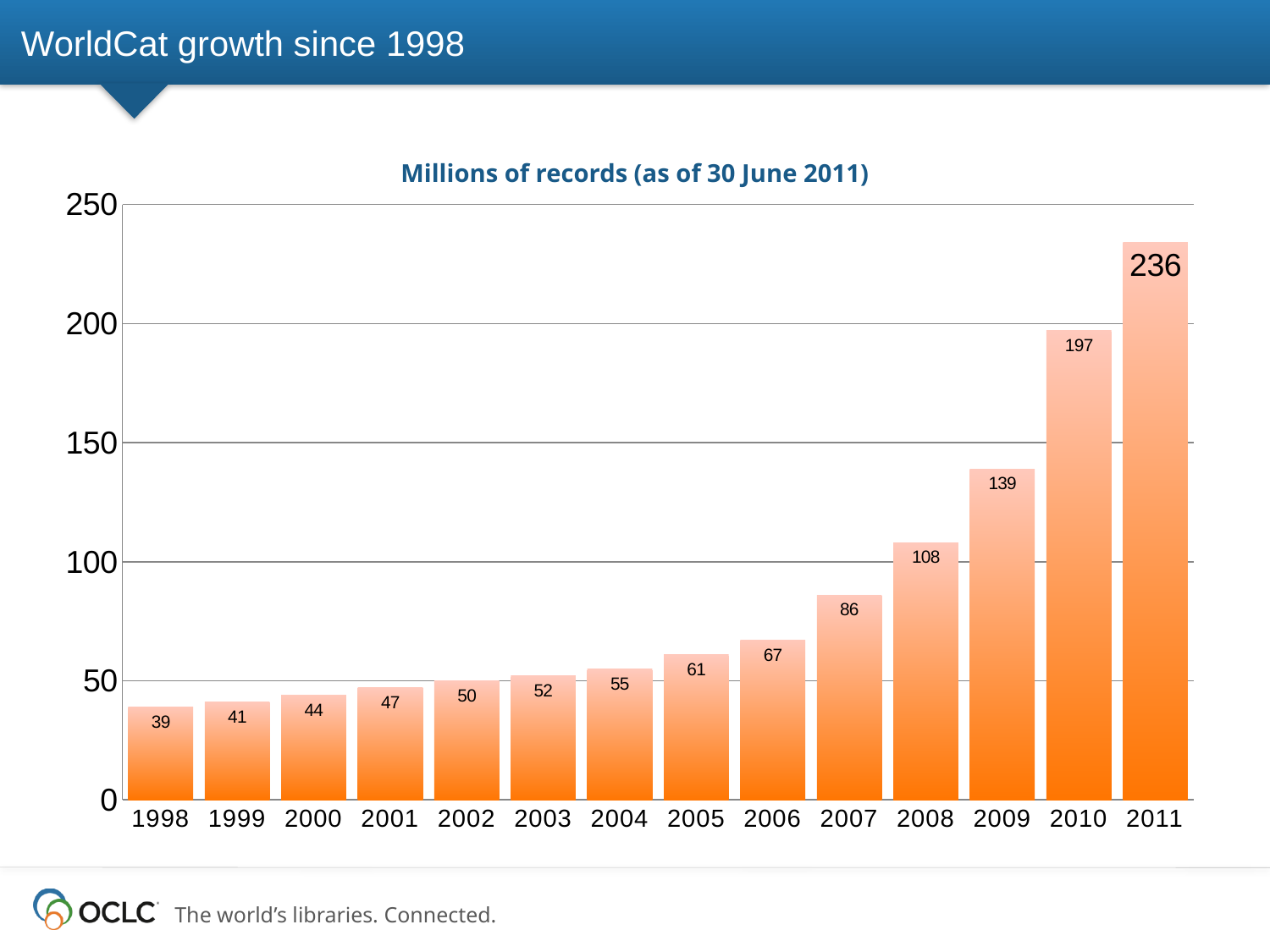
Which is larger, the value for 2007 or the value for 2006? 2007 What is the difference between the values for 2009 and 2008? 31 What is the value for 2011? 236 Do the values rise or fall from 1998 to 2011? rise What is the difference between the values for 2011 and 2010? 39 What is the value for 1998? 39 How many years are shown on the x axis? 14 What kind of chart is this? bar chart Which year has the highest value? 2011 Is the value for 2010 greater or less than 150? greater Which year has the lowest value? 1998 What is the value for 2008? 108